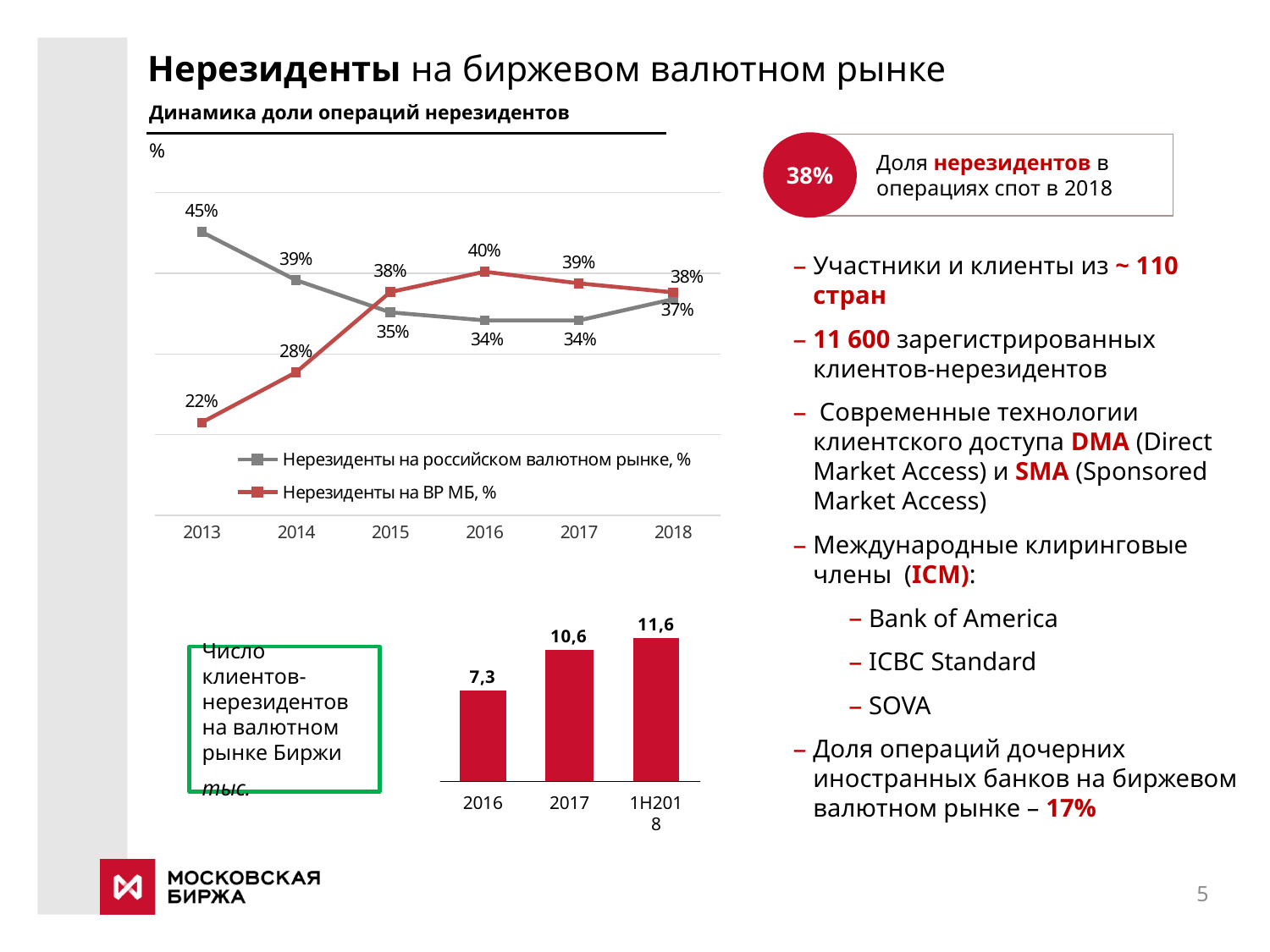
In the line chart 'Динамика доли операций нерезидентов', in which year is 'Нерезиденты на российском валютном рынке, %' highest? 2013 In the line chart 'Динамика доли операций нерезидентов', what is the difference between the two series in 2013? 23 percentage points In the bar chart 'Число клиентов-нерезидентов на валютном рынке Биржи', what is the value for 2017? 10,6 In the line chart 'Динамика доли операций нерезидентов', what is the value for 'Нерезиденты на ВР МБ, %' in 2016? 40% In the bar chart 'Число клиентов-нерезидентов на валютном рынке Биржи', what is the difference between 1H2018 and 2016? 4,3 What kind of chart is the lower chart 'Число клиентов-нерезидентов на валютном рынке Биржи'? bar chart In the line chart 'Динамика доли операций нерезидентов', in which year is 'Нерезиденты на ВР МБ, %' highest? 2016 In the line chart 'Динамика доли операций нерезидентов', which series has the larger value in 2015? Нерезиденты на ВР МБ, % In the line chart 'Динамика доли операций нерезидентов', what is the value for 'Нерезиденты на ВР МБ, %' in 2013? 22% In the line chart 'Динамика доли операций нерезидентов', does 'Нерезиденты на ВР МБ, %' rise or fall from 2013 to 2016? rise In the line chart 'Динамика доли операций нерезидентов', how many series does the legend list? 2 In the line chart 'Динамика доли операций нерезидентов', what is the value for 'Нерезиденты на российском валютном рынке, %' in 2013? 45%